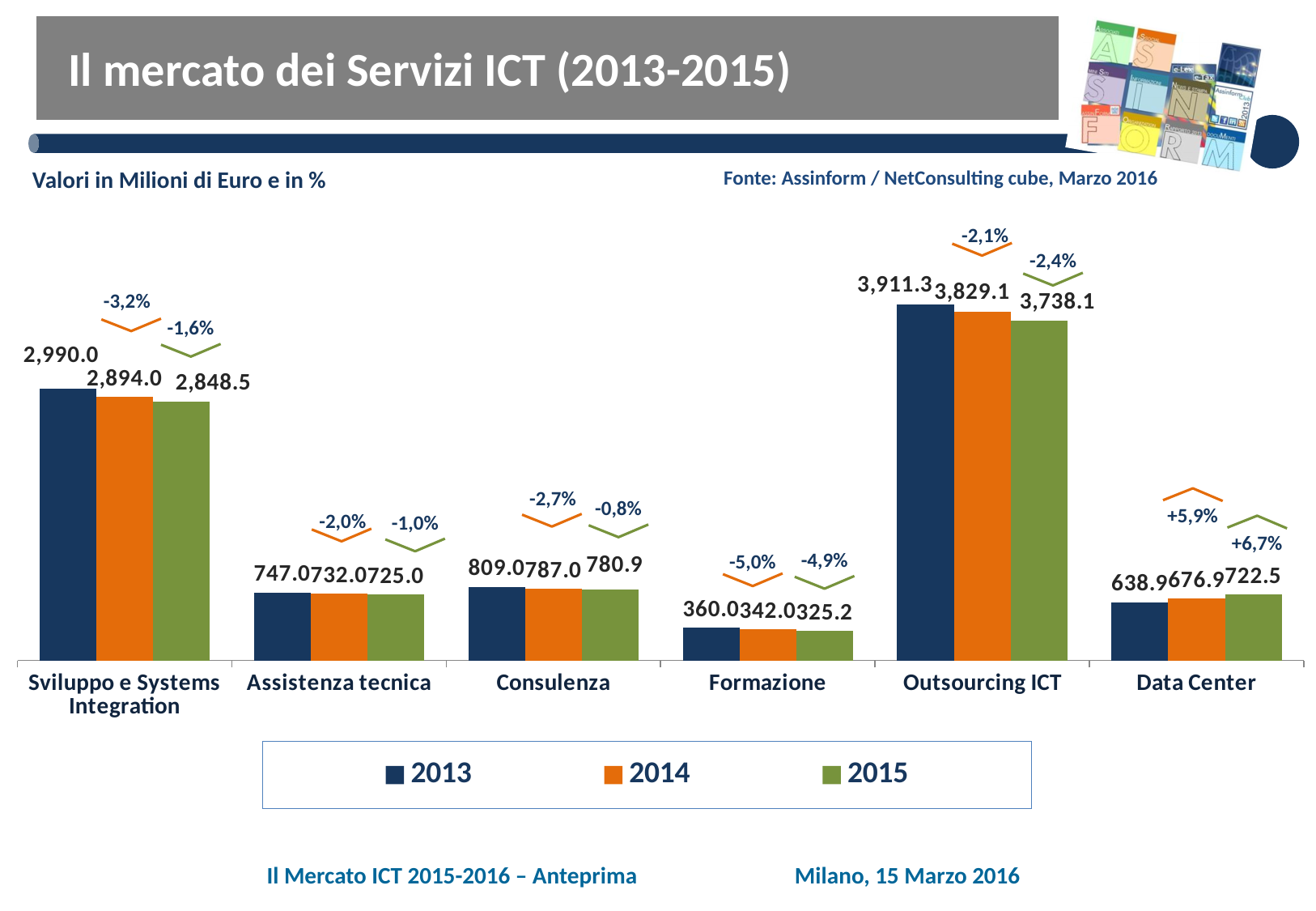
Which category has the highest value in 2015? Outsourcing ICT What kind of chart is shown on the slide? Bar chart How many series does the legend list? 3 Which category has the lowest value in 2013? Formazione What is the value for Formazione in 2014? 342.0 How many categories are shown on the x axis? 6 What is the value for Outsourcing ICT in 2013? 3,911.3 By how much did the Data Center value increase from 2013 to 2015? 83.6 Which is larger: the 2015 value for Consulenza or the 2015 value for Assistenza tecnica? Consulenza What is the value for Data Center in 2015? 722.5 What percentage change is shown for Data Center between 2014 and 2015? +6,7% What is the difference between the 2013 and 2015 values for Outsourcing ICT? 173.2